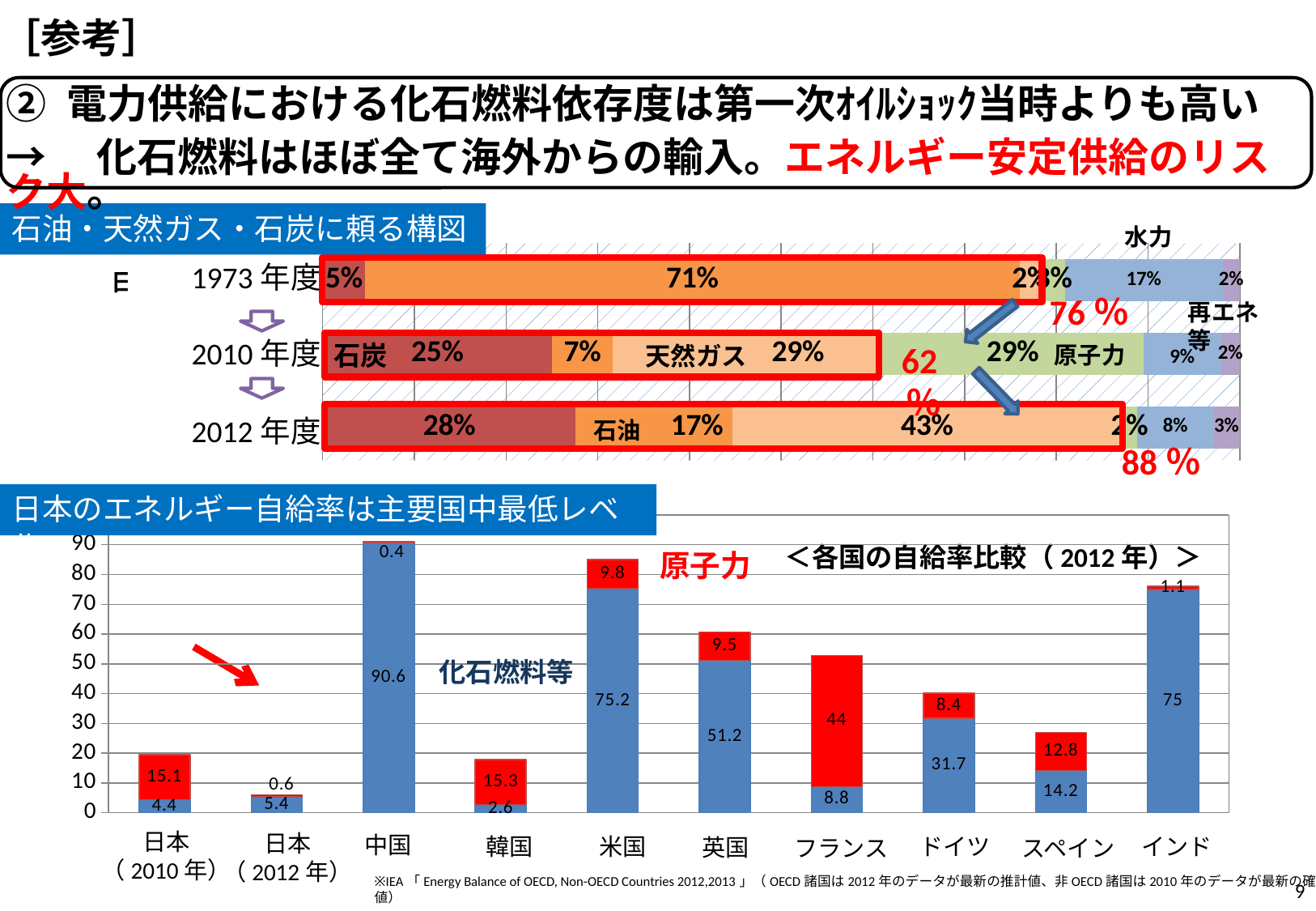
In the bottom chart (各国の自給率比較), what is the 原子力 value for フランス? 44 In the bottom chart (各国の自給率比較), what is the total of the stacked bar for フランス? 52.8 What kind of chart is the bottom chart (各国の自給率比較)? Stacked bar chart In the top chart (石油・天然ガス・石炭に頼る構図), what is the 天然ガス share for 2012年度? 43% In the top chart (石油・天然ガス・石炭に頼る構図), what is the 石油 share for 1973年度? 71% In the bottom chart (各国の自給率比較), which country has the lowest 化石燃料等 value? 韓国 In the bottom chart (各国の自給率比較), what is the total of the stacked bar for 日本（2010年）? 19.5 In the bottom chart (各国の自給率比較), which country has the highest 化石燃料等 value? 中国 In the bottom chart (各国の自給率比較), how many countries/categories are shown on the x axis? 10 In the bottom chart (各国の自給率比較), which has the larger 化石燃料等 value, ドイツ or スペイン? ドイツ In the top chart (石油・天然ガス・石炭に頼る構図), what is the difference between the 石炭 share in 2012年度 and in 2010年度? 3% In the bottom chart (各国の自給率比較), what is the 化石燃料等 value for 中国? 90.6